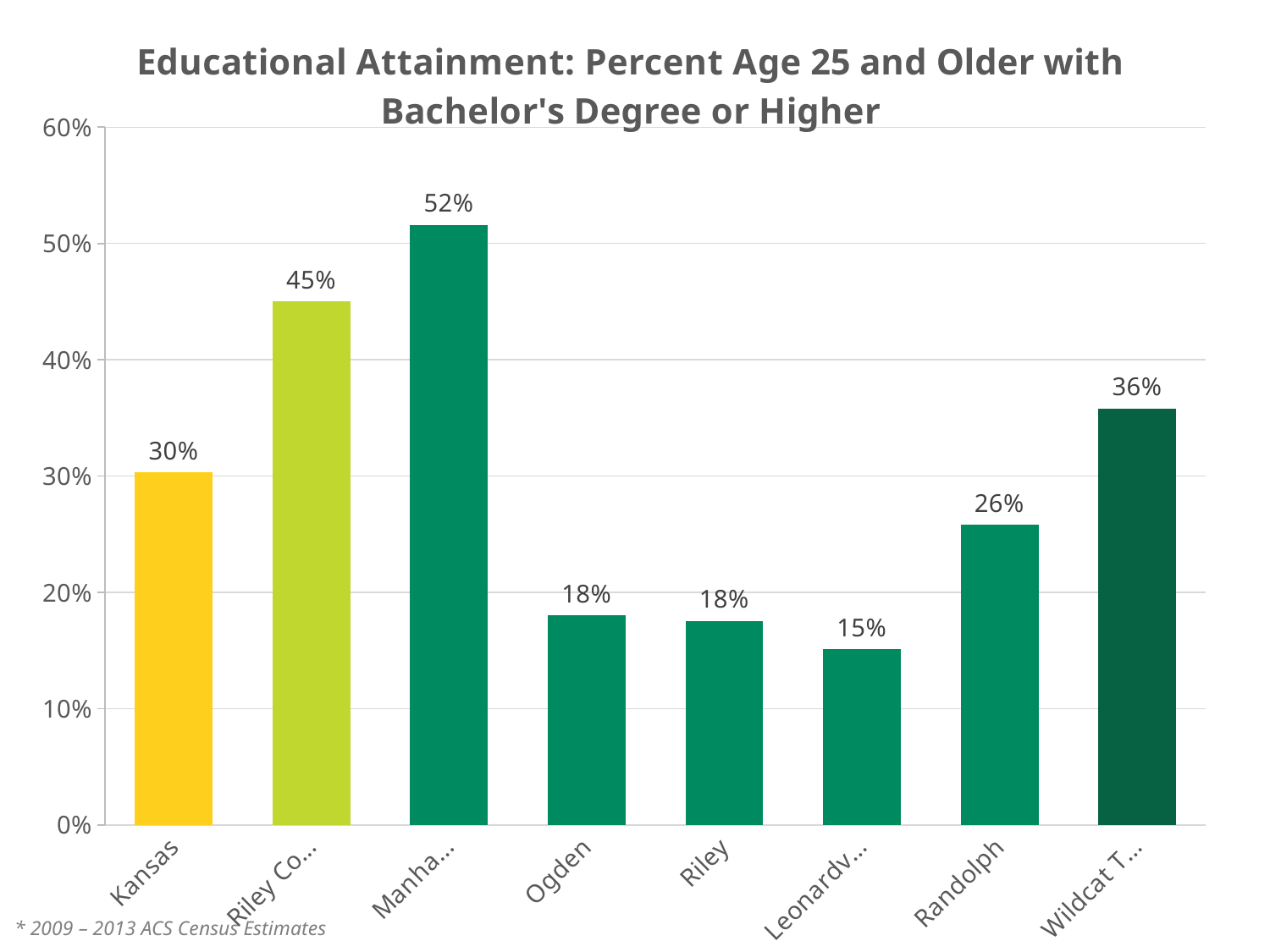
What is the difference between the values for Kansas and Randolph? 4% Is the value for Randolph greater or less than 30%? less What is the lowest value shown on the chart? 15% How many bars are shown on the chart? 8 Which is larger, the value for Kansas or the value for Ogden? Kansas What is the value for Riley? 18% What colour is the bar for Kansas? yellow What is the value for Kansas? 30% What is the value for Randolph? 26% What kind of chart is shown on the slide? bar chart What is the value for Ogden? 18% What is the highest value shown on the chart? 52%